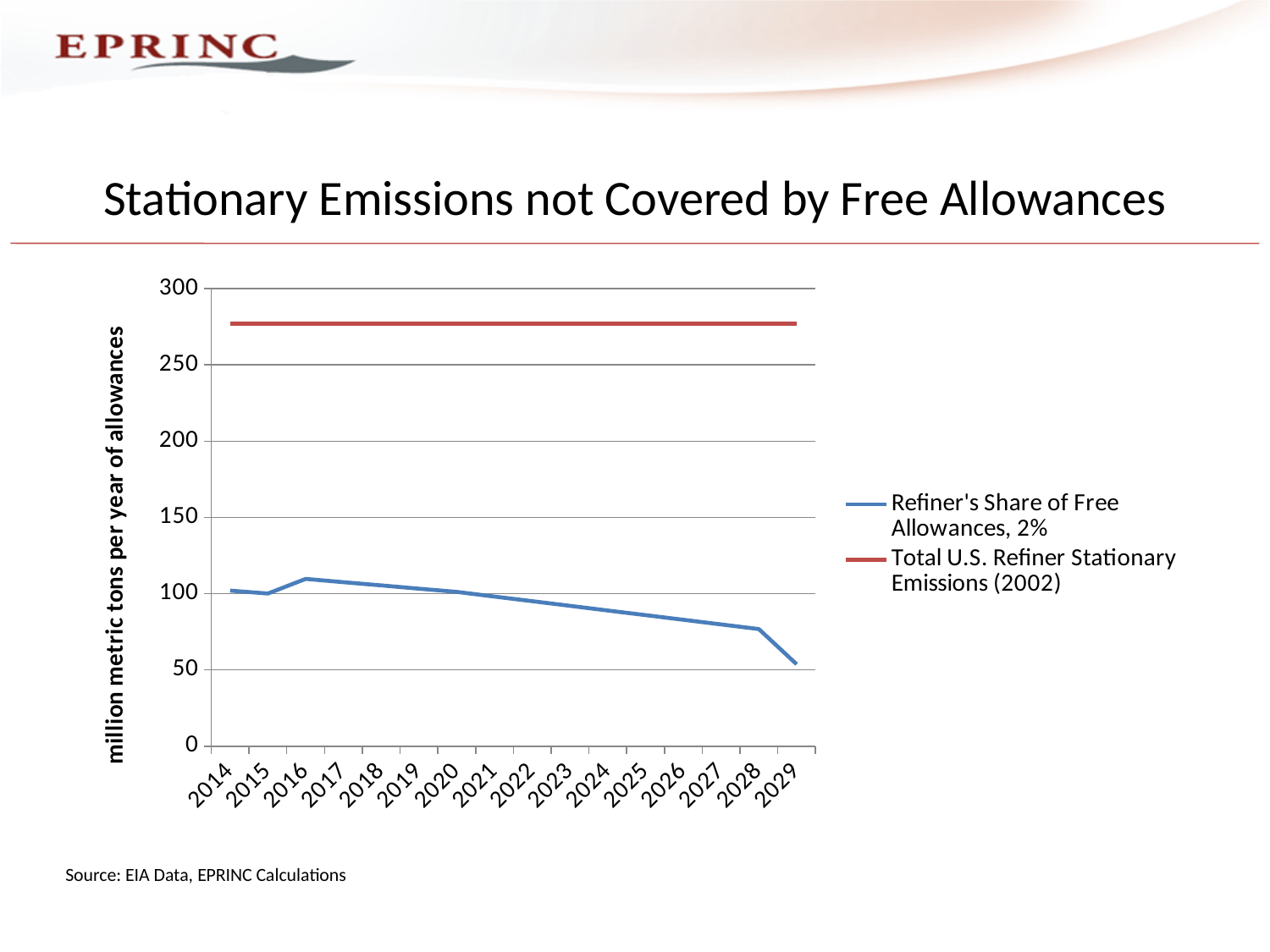
What is the label on the vertical axis? million metric tons per year of allowances In which year is the Refiner's Share of Free Allowances, 2% line at its lowest? 2029 Is the value for Refiner's Share of Free Allowances, 2% in 2016 greater or less than 100? greater Which series has the larger value in 2020, Refiner's Share of Free Allowances, 2% or Total U.S. Refiner Stationary Emissions (2002)? Total U.S. Refiner Stationary Emissions (2002) What kind of chart is shown on the slide? line chart How many years are shown on the x axis? 16 Is the value for Total U.S. Refiner Stationary Emissions (2002) greater or less than 250? greater In which year is the Refiner's Share of Free Allowances, 2% line at its highest? 2016 What is the title of the chart? Stationary Emissions not Covered by Free Allowances Is the value for Refiner's Share of Free Allowances, 2% in 2028 greater or less than 100? less How many series does the legend list? 2